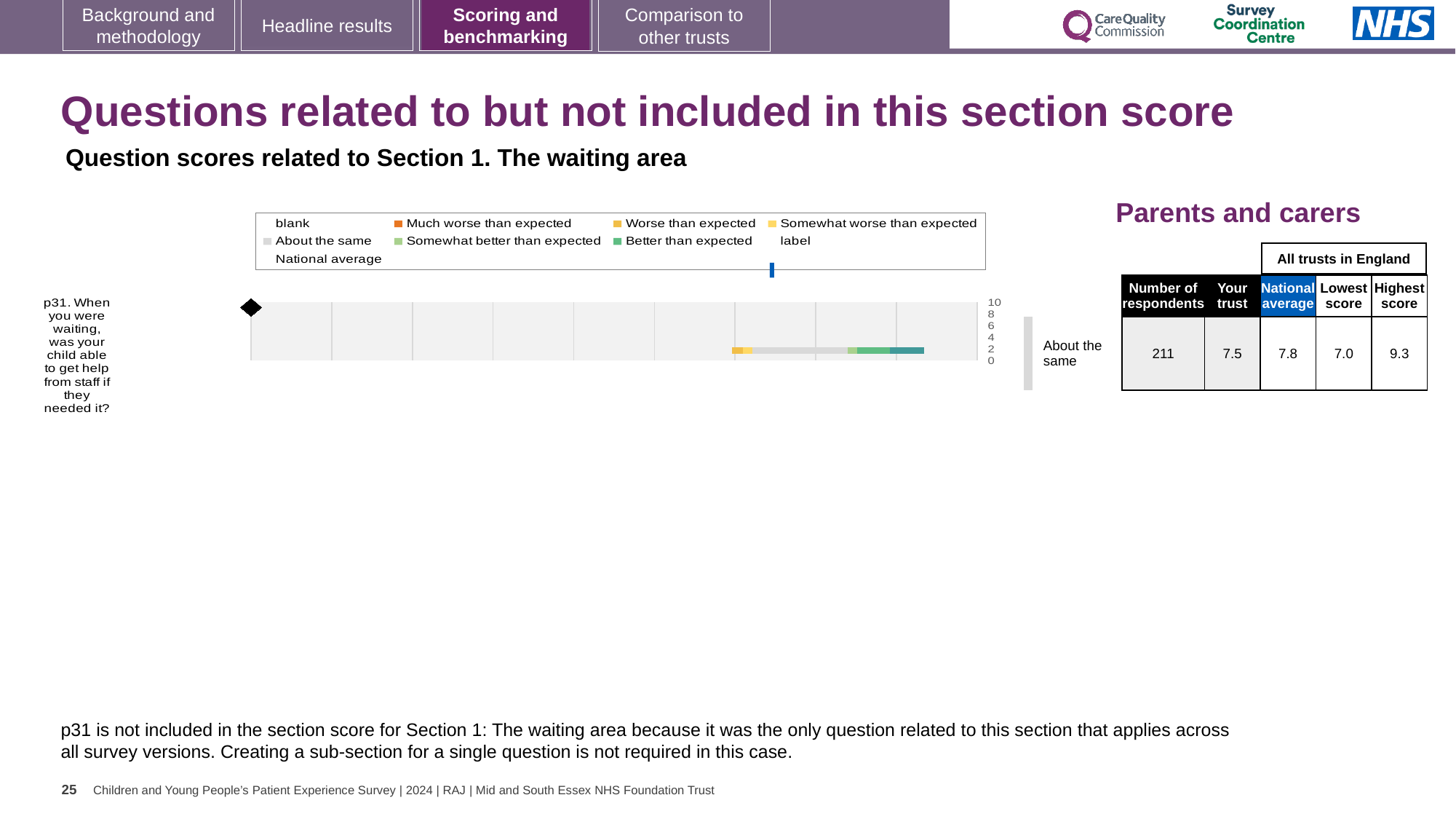
In the Parents and carers table, what is the Number of respondents for p31? 211 In the Parents and carers table, what is the National average score for p31? 7.8 How many entries does the chart legend list? 9 In the Parents and carers table, what is the Highest score among all trusts in England for p31? 9.3 Which is larger for p31: the Your trust score or the National average? National average In the Parents and carers table, what is the Lowest score among all trusts in England for p31? 7.0 In the Parents and carers table, what is the 'Your trust' score for p31? 7.5 What is the highest value shown on the chart's score axis? 10 What is the difference between the Highest score and the Lowest score for p31 in the table? 2.3 Which benchmark category label is shown next to the bar for p31? About the same What kind of chart is used to show the p31 question score? bar chart How many questions (categories) are plotted in the chart? 1